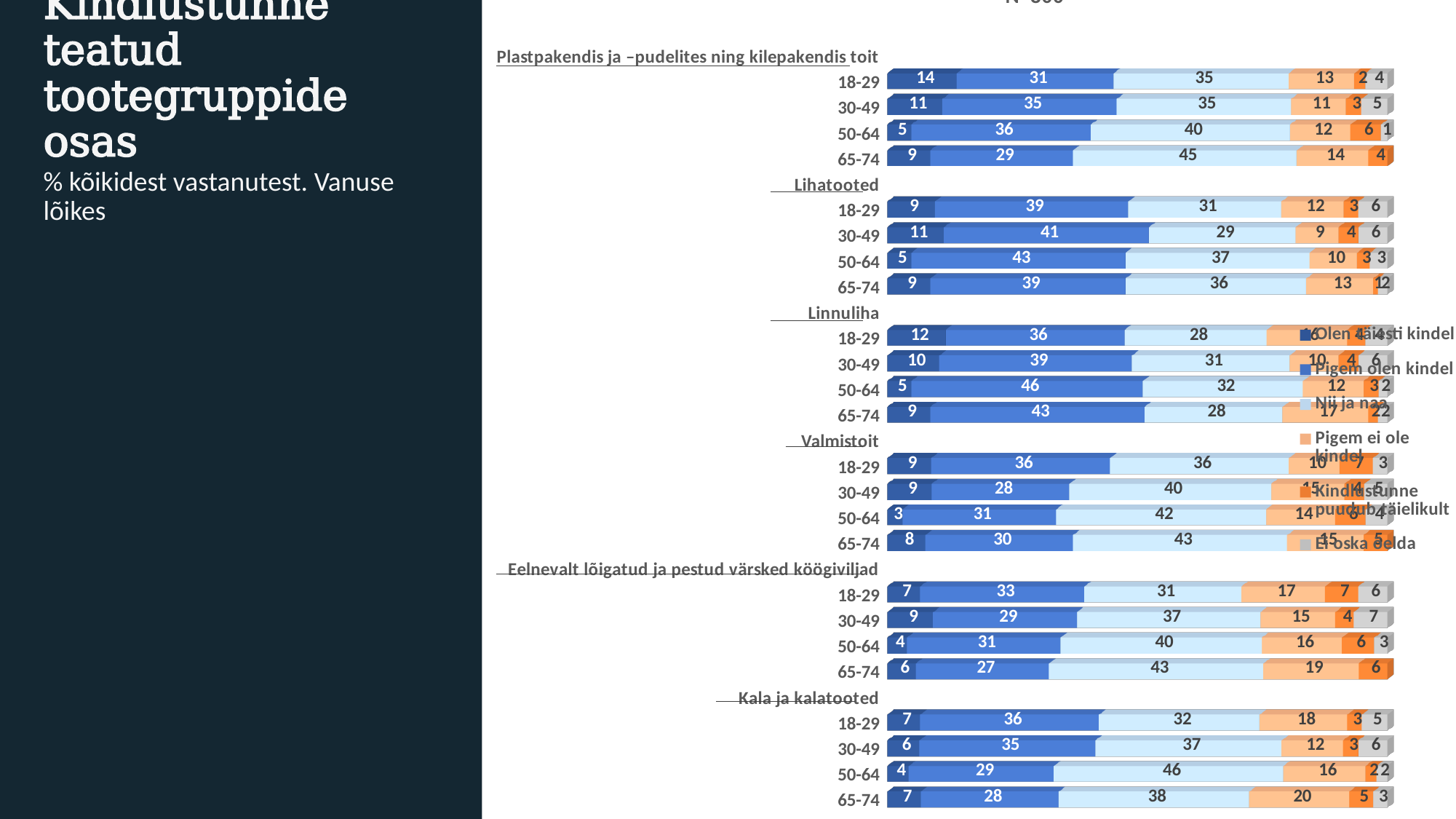
Which legend entry is shown in the lightest blue colour? Nii ja naa In the Lihatooted group, which is larger: the 'Pigem olen kindel' value for 30-49 or for 18-29? 30-49 In the Kala ja kalatooted group, what is the 'Nii ja naa' value for the 50-64 age group? 46 In the Valmistoit group, what is the difference between the 'Nii ja naa' values for the 65-74 and 18-29 age groups? 7 In the Eelnevalt lõigatud ja pestud värsked köögiviljad group, what is the 'Pigem ei ole kindel' value for the 65-74 age group? 19 What kind of chart is shown on the slide? stacked bar chart In the Linnuliha group, which age group has the highest 'Pigem olen kindel' value? 50-64 In the Kala ja kalatooted group, which age group has the lowest 'Pigem ei ole kindel' value? 30-49 How many series does the legend list? 6 In the Lihatooted group, what is the 'Pigem olen kindel' value for the 50-64 age group? 43 How many product groups are shown in the chart? 6 In the Plastpakendis ja -pudelites ning kilepakendis toit group, what is the 'Olen täiesti kindel' value for the 18-29 age group? 14